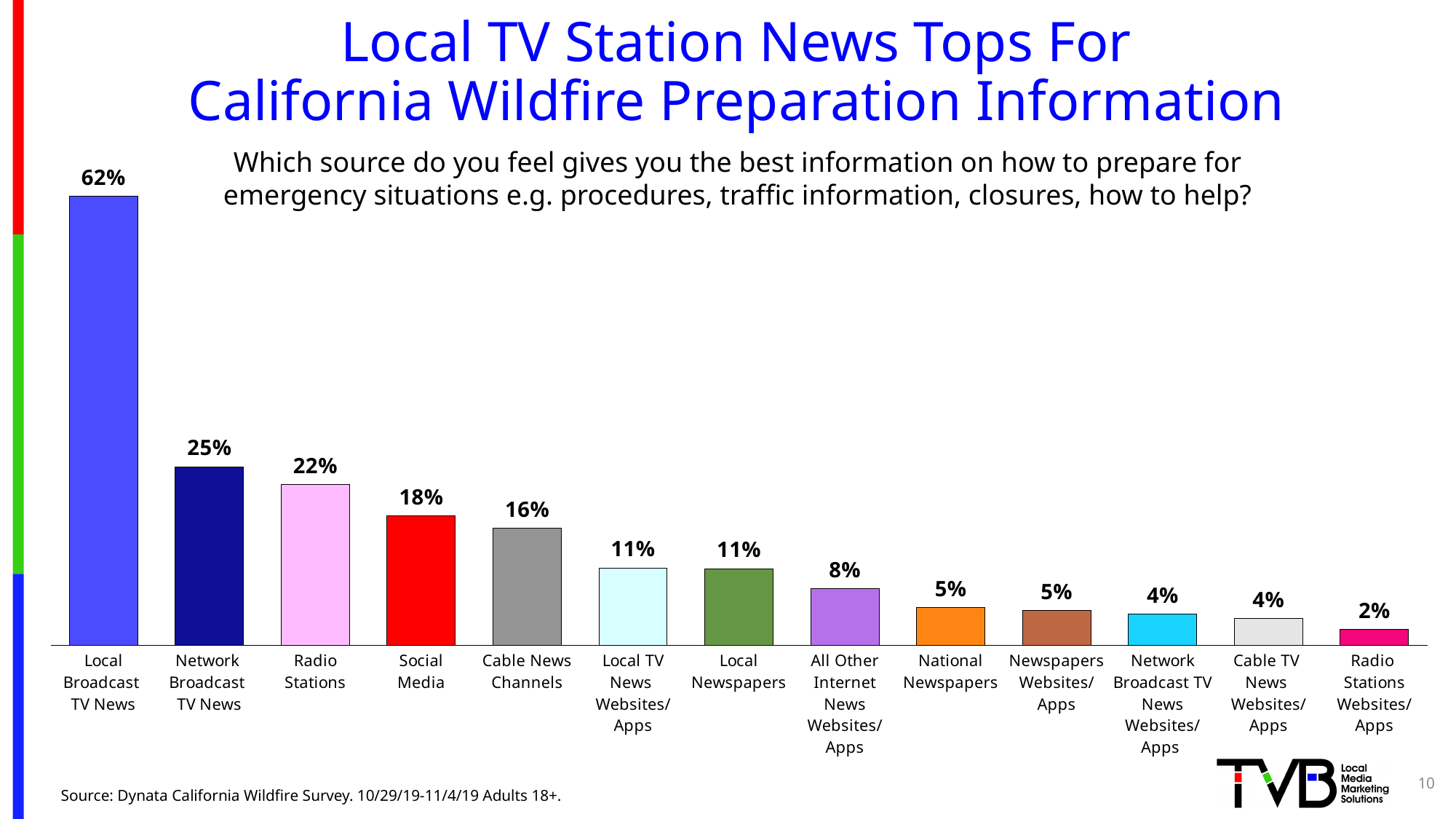
What kind of chart is shown on the slide? Bar chart How many sources (categories) are shown on the chart? 13 Do the values rise or fall moving from left to right across the chart? Fall What is the value shown for All Other Internet News Websites/Apps? 8% Which has a higher value, Social Media or Cable News Channels? Social Media Which source has the lowest value on the chart? Radio Stations Websites/Apps What is the difference between the values for Local Broadcast TV News and Network Broadcast TV News? 37 percentage points Which has a higher value, National Newspapers or Local Newspapers? Local Newspapers What is the value shown for Social Media? 18% What is the difference between the values for Radio Stations and Cable News Channels? 6 percentage points Which source has the highest value on the chart? Local Broadcast TV News What percentage of respondents chose Local Broadcast TV News as the best source for emergency preparation information? 62%